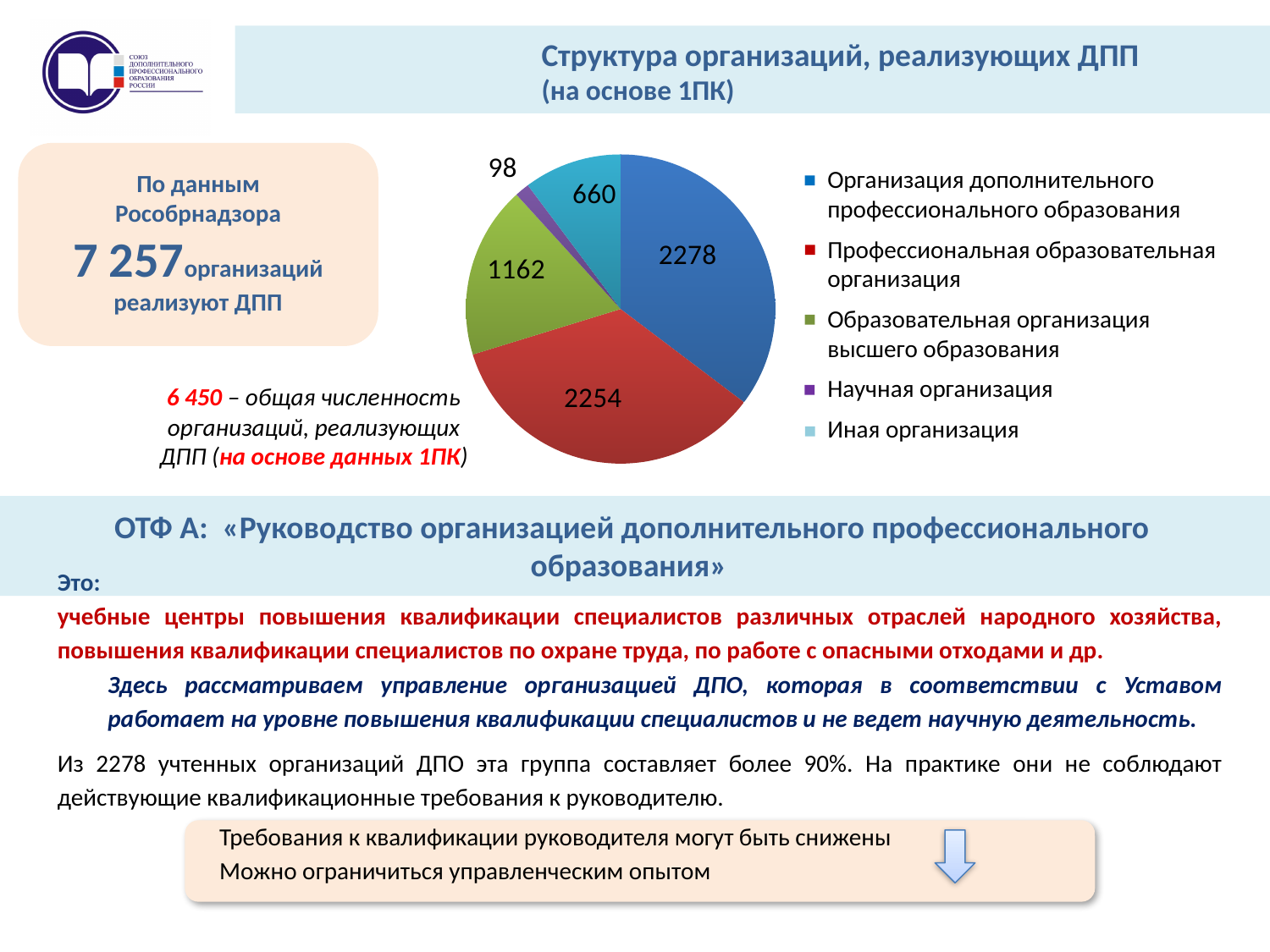
How many entries does the legend of the pie chart list? 5 How many slices does the pie chart have? 5 What is the value for 'Организация дополнительного профессионального образования' in the pie chart? 2278 Which category has the smallest slice in the pie chart? Научная организация What is the value for 'Иная организация' in the pie chart? 660 Which is larger: the value for 'Иная организация' or the value for 'Научная организация'? Иная организация What is the value for 'Научная организация' in the pie chart? 98 Which category has the largest slice in the pie chart? Организация дополнительного профессионального образования What is the value for 'Образовательная организация высшего образования' in the pie chart? 1162 What is the difference between the values for 'Образовательная организация высшего образования' and 'Иная организация'? 502 What is the value for 'Профессиональная образовательная организация' in the pie chart? 2254 What type of chart is shown on the slide? pie chart